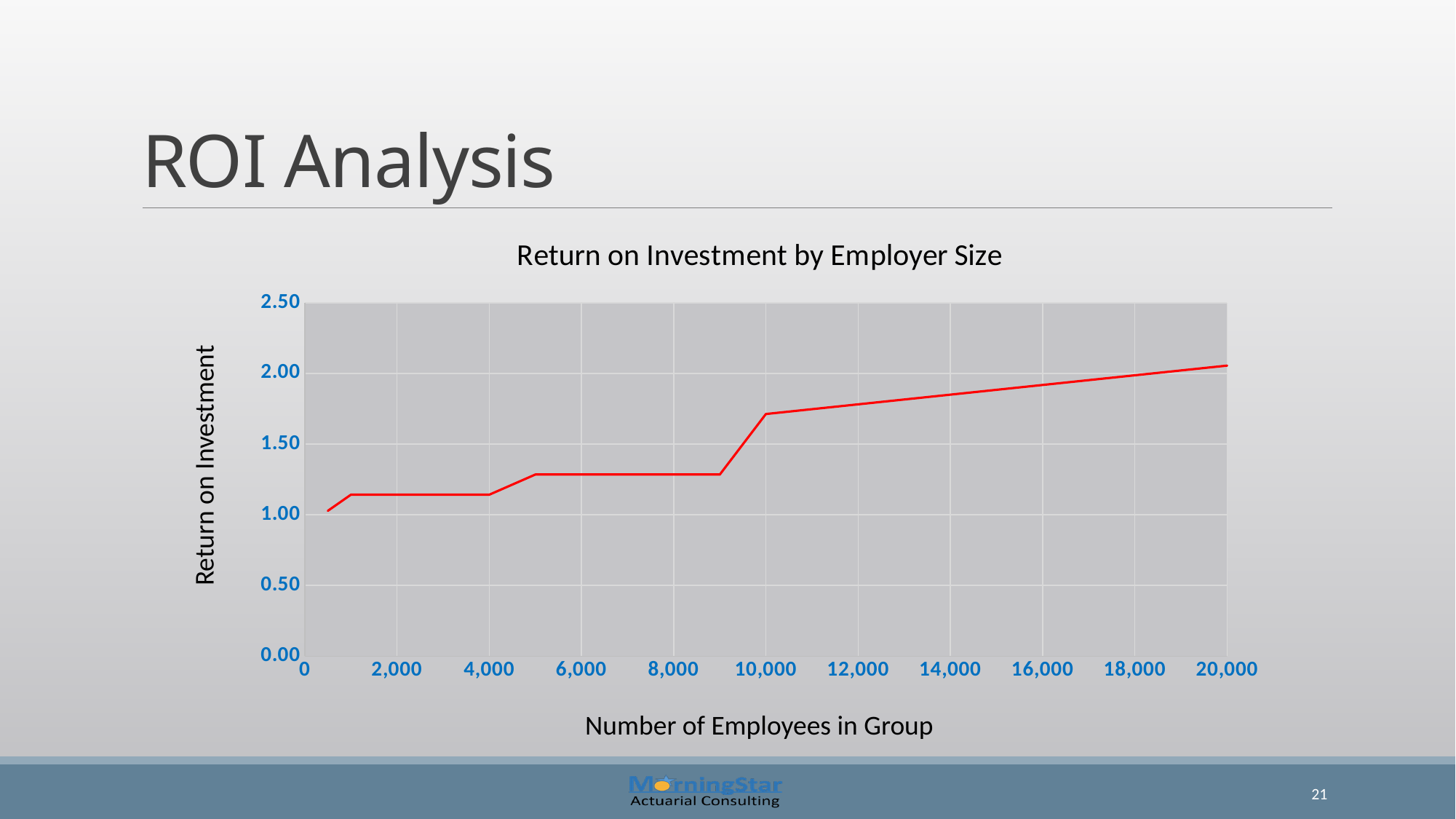
What kind of chart is shown on the slide? line chart Is the return on investment for a group of 20,000 employees greater or less than 1.50? greater Is the return on investment for a group of 6,000 employees greater or less than 1.00? greater Is the return on investment for a group of 16,000 employees greater or less than 1.50? greater At which group size shown on the x axis does the return on investment reach its highest value? 20,000 Which group size has the higher return on investment, 8,000 employees or 14,000 employees? 14,000 employees What is the label of the x axis? Number of Employees in Group What is the title of the chart? Return on Investment by Employer Size Does the return on investment generally rise or fall as the number of employees in the group increases? rise